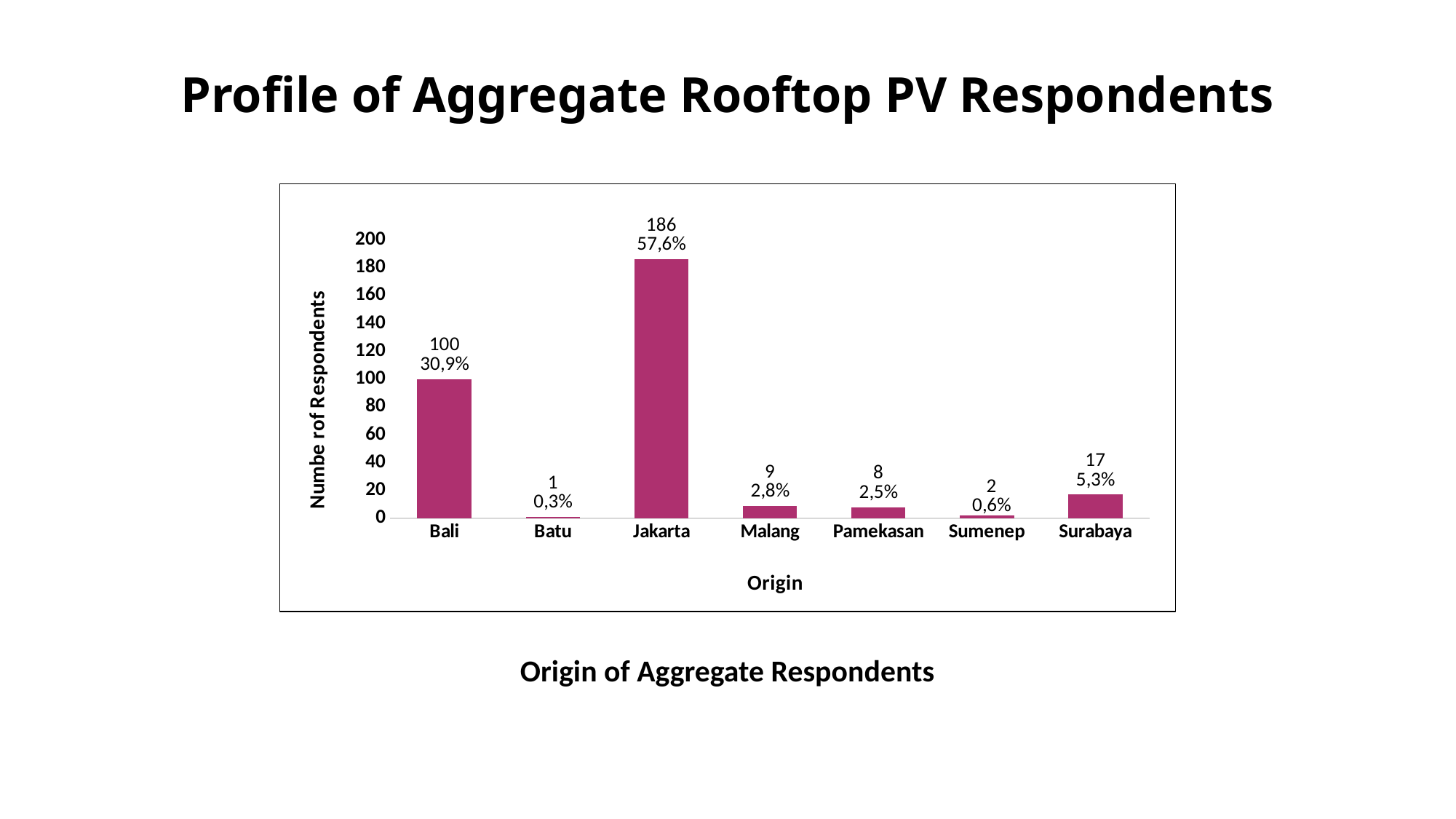
How many respondents are from Bali? 100 Which has more respondents, Malang or Surabaya? Surabaya What is the difference in the number of respondents between Jakarta and Bali? 86 What is the label of the y axis? Numbe rof Respondents Which origin has the highest number of respondents? Jakarta What percentage of respondents are from Surabaya? 5,3% How many respondents are from Jakarta? 186 How many origin categories are shown on the x axis? 7 Which origin has the lowest number of respondents? Batu What is the label of the x axis? Origin What kind of chart is shown on the slide? Bar chart How many respondents are from Pamekasan? 8